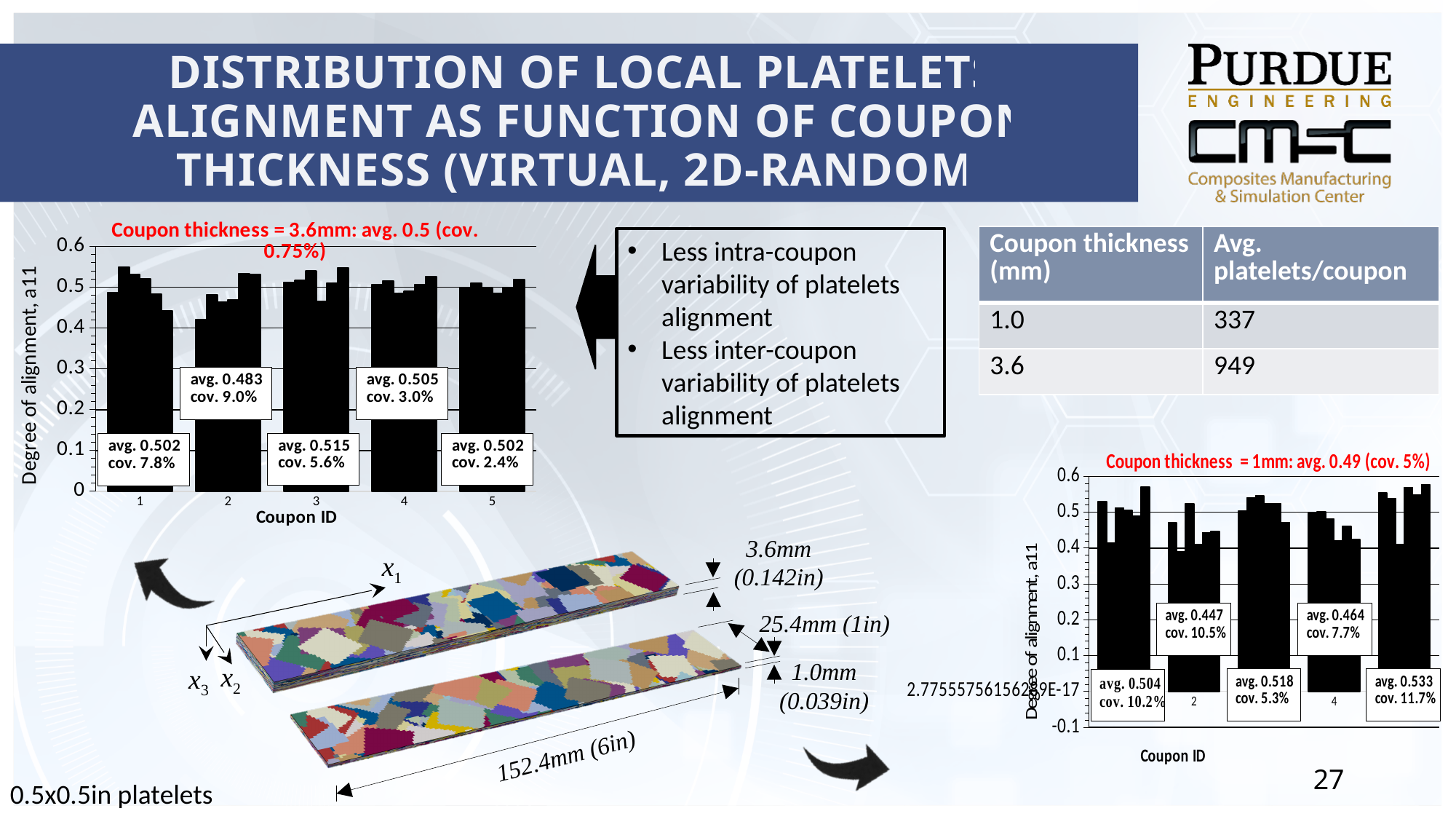
In the bottom-right chart (coupon thickness = 1mm), which coupon has the highest annotated coefficient of variation? 5 In the bottom-right chart (coupon thickness = 1mm), which coupon has the lowest annotated average degree of alignment? 2 In the top-left chart (coupon thickness = 3.6mm), what is the difference between the annotated averages of coupon 3 and coupon 2? 0.032 In the top-left chart (coupon thickness = 3.6mm), which coupon ID has the lowest annotated average degree of alignment? 2 In the top-left chart (coupon thickness = 3.6mm), what coefficient of variation is annotated for coupon 5? 2.4% How many coupon IDs are shown on the x axis of the top-left chart (coupon thickness = 3.6mm)? 5 In the bottom-right chart (coupon thickness = 1mm), what is the average degree of alignment annotated for coupon 5? 0.533 What type of chart is the bottom-right chart (coupon thickness = 1mm)? Bar chart In the bottom-right chart (coupon thickness = 1mm), is the annotated average for coupon 1 or coupon 4 larger? Coupon 1 In the top-left chart (coupon thickness = 3.6mm), what is the average degree of alignment annotated for coupon 2? 0.483 In the bottom-right chart (coupon thickness = 1mm), what coefficient of variation is annotated for coupon 3? 5.3% In the top-left chart (coupon thickness = 3.6mm), which coupon ID has the highest annotated average degree of alignment? 3